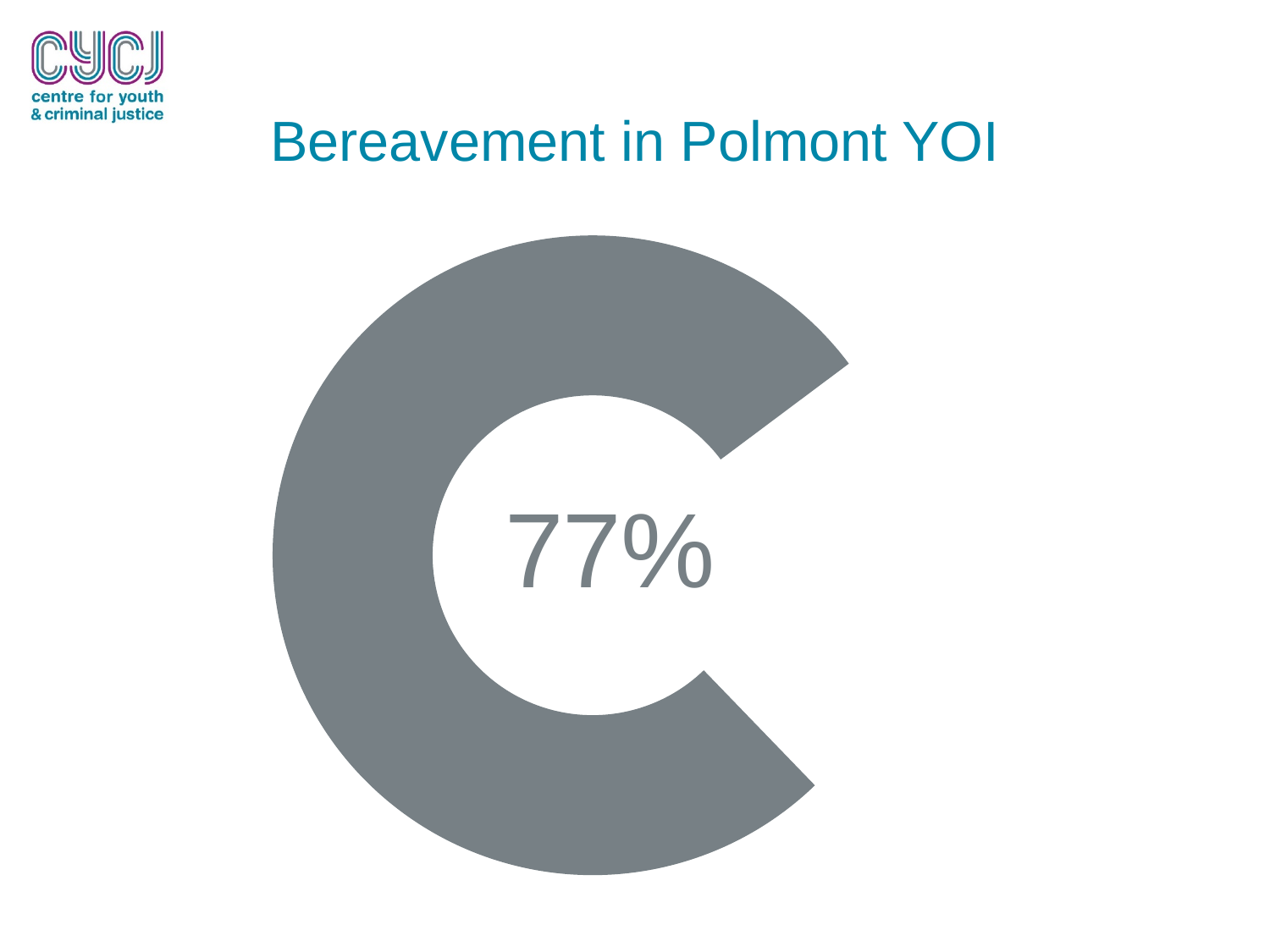
What percentage is printed in the centre of the doughnut chart? 77% What is the title of the slide containing the doughnut chart? Bereavement in Polmont YOI What percentage of the doughnut chart is not covered by the grey segment? 23% What kind of chart is shown on the slide? Doughnut chart How many percentage values are printed on the doughnut chart? 1 Is the grey segment of the doughnut chart greater or less than 50%? greater What share of the doughnut chart does the grey segment represent? 77% What colour is the filled segment of the doughnut chart? Grey